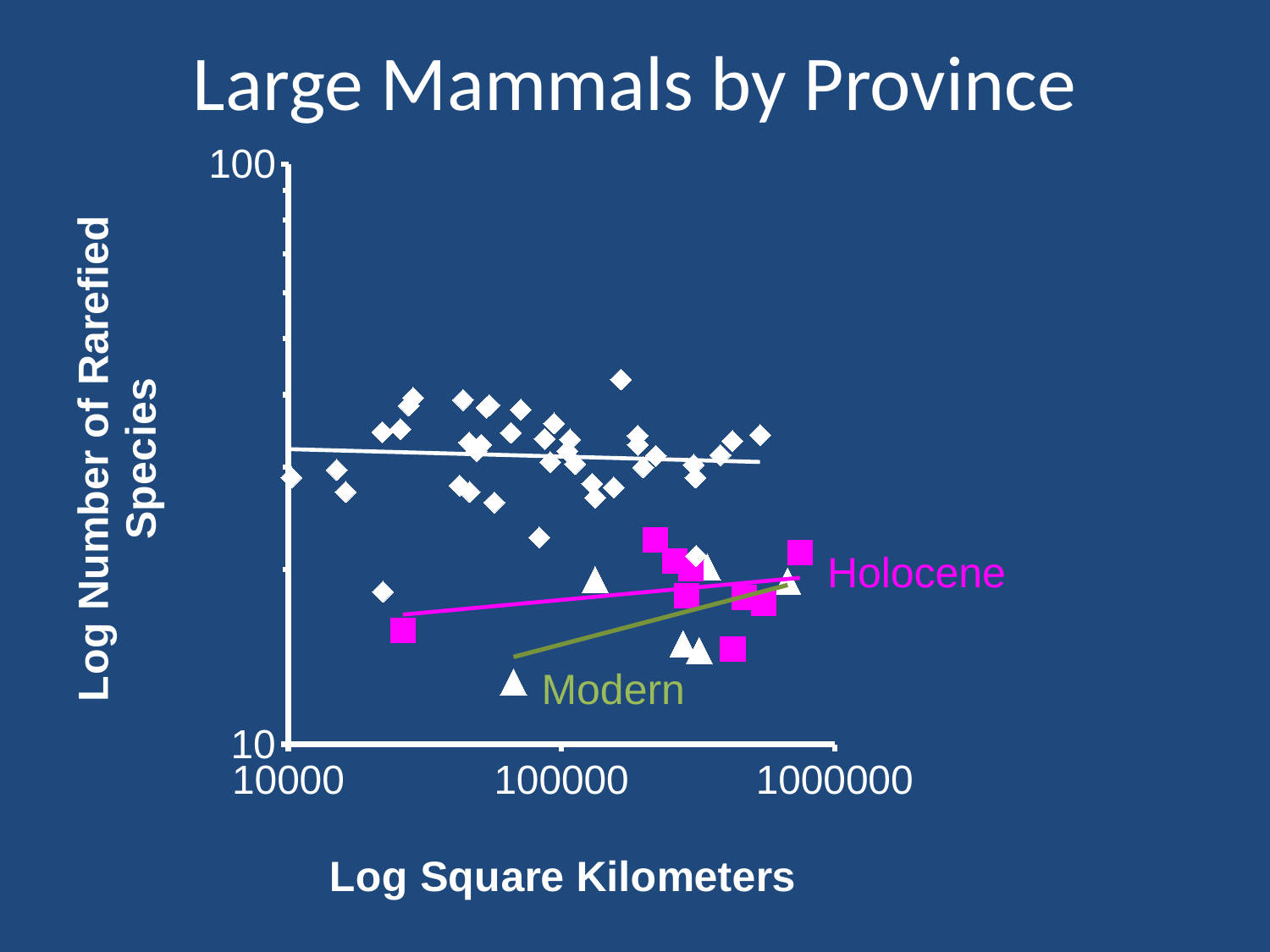
What is the highest value shown on the y axis? 100 Does the Modern trend line rise or fall as the x axis increases? Rises What is the label of the x axis? Log Square Kilometers Are the Holocene points generally higher or lower on the y axis than the white diamond points? Lower Does the Holocene trend line rise or fall as the x axis increases? Rises What kind of chart is shown on the slide? Scatter chart What is the lowest value shown on the y axis? 10 What is the largest value shown on the x axis? 1000000 Which series is plotted with magenta squares? Holocene What is the title of the chart? Large Mammals by Province What is the smallest value shown on the x axis? 10000 Are all the Modern points greater or less than 100 on the y axis? less